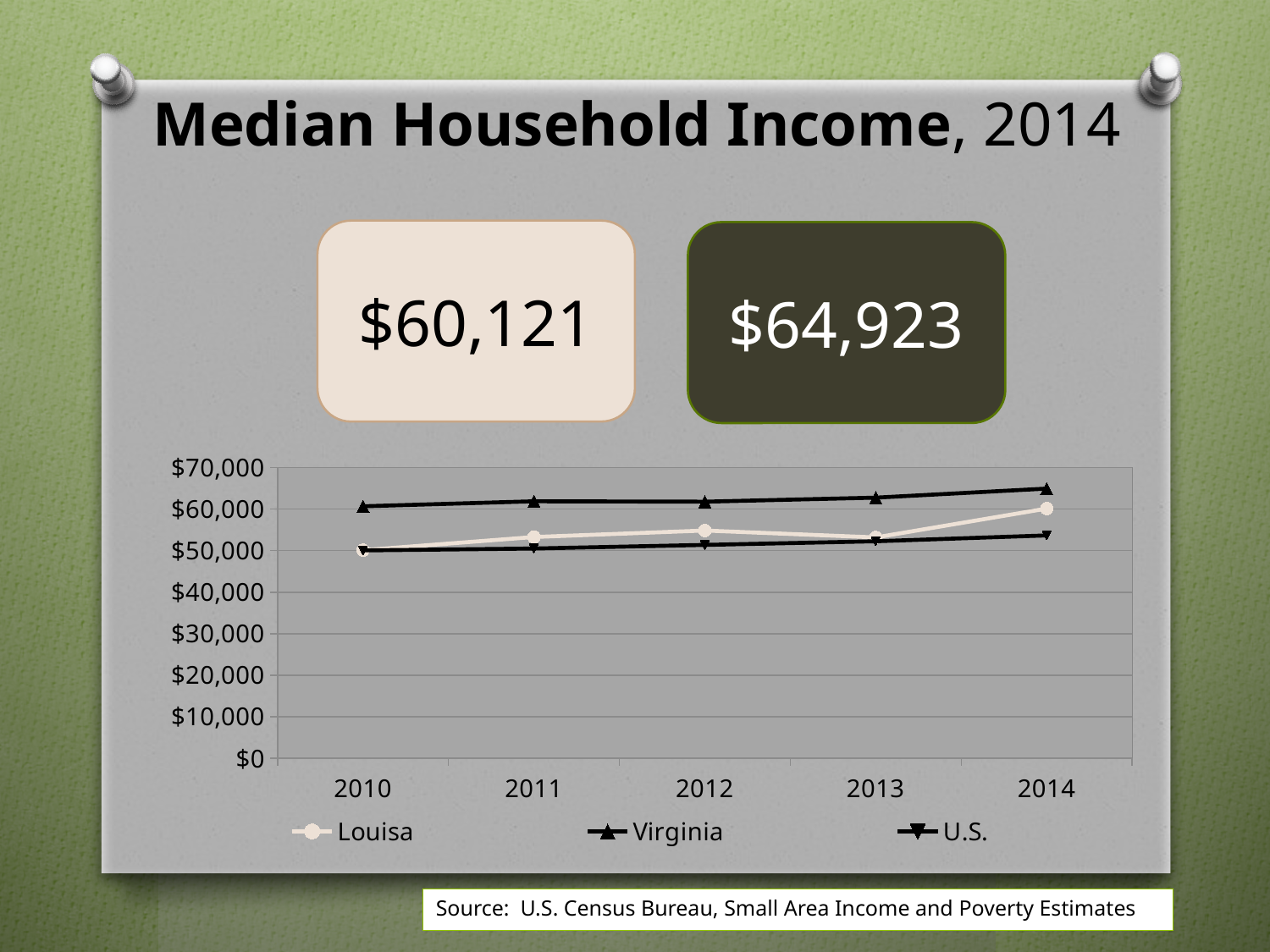
What kind of chart is shown on the slide? line chart Is the value for Louisa in 2012 greater or less than $60,000? less Which series has the highest value in 2014? Virginia Which series has the lowest value in 2014? U.S. Is the value for U.S. in 2014 greater or less than $60,000? less Is the value for Virginia in 2010 greater or less than $50,000? greater In 2014, which is larger: the value for Louisa or the value for U.S.? Louisa How many years are plotted along the x axis of the chart? 5 Does the Virginia series rise or fall from 2010 to 2014? rise How many series does the chart's legend list? 3 In 2010, which is larger: the value for Virginia or the value for Louisa? Virginia What is the title of the slide containing the chart? Median Household Income, 2014